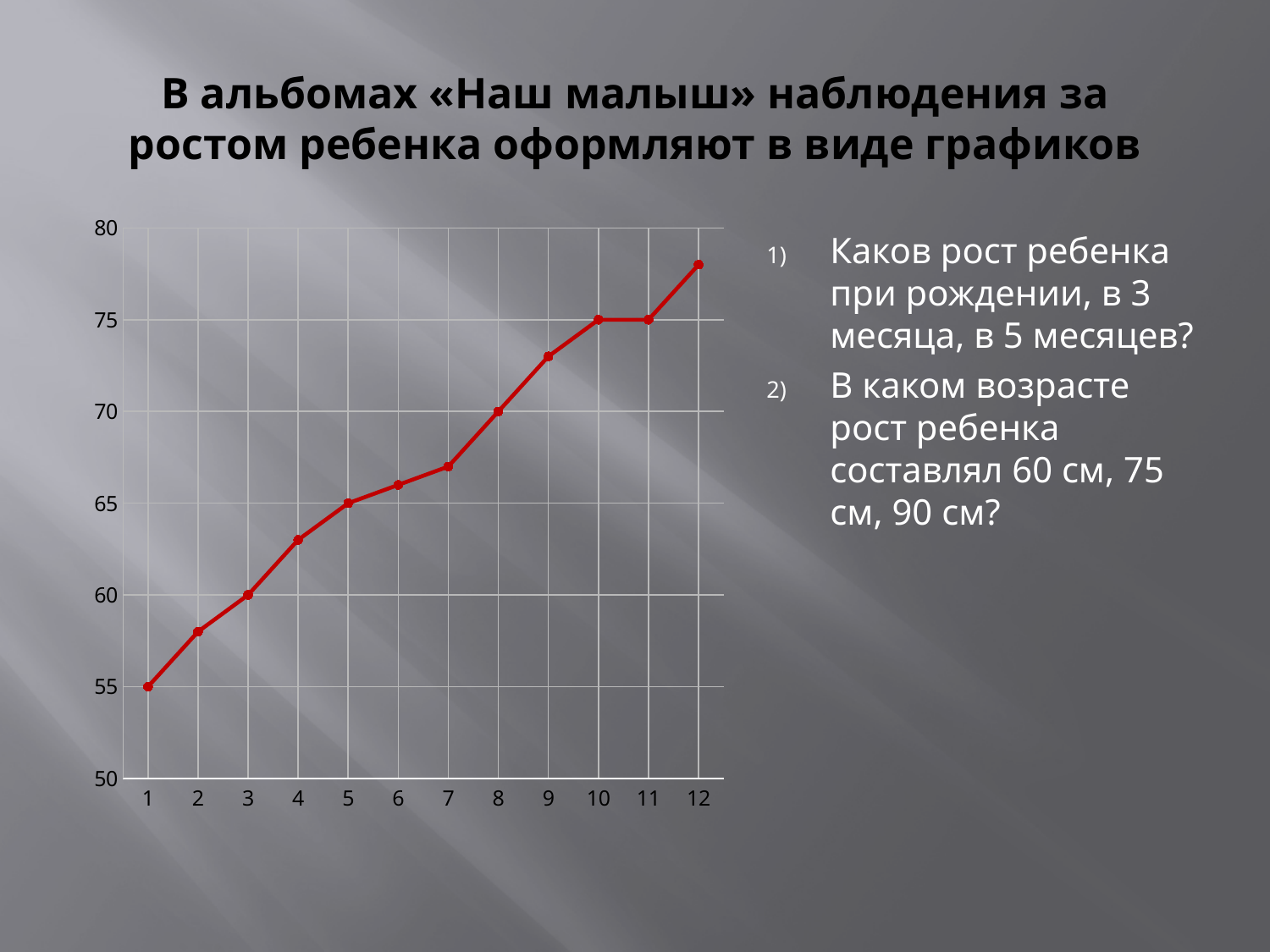
What is the value at x = 10? 75 Is the value at x = 2 greater or less than 60? less What is the value at x = 3? 60 At which x value is the plotted value highest? 12 What is the difference between the values at x = 10 and x = 5? 10 How many data points are plotted on the line? 12 What is the value at x = 8? 70 What is the value at x = 1? 55 What kind of chart is shown on the slide? line chart At which x value is the plotted value lowest? 1 Do the values rise or fall as x increases from 1 to 12? rise What is the value at x = 5? 65